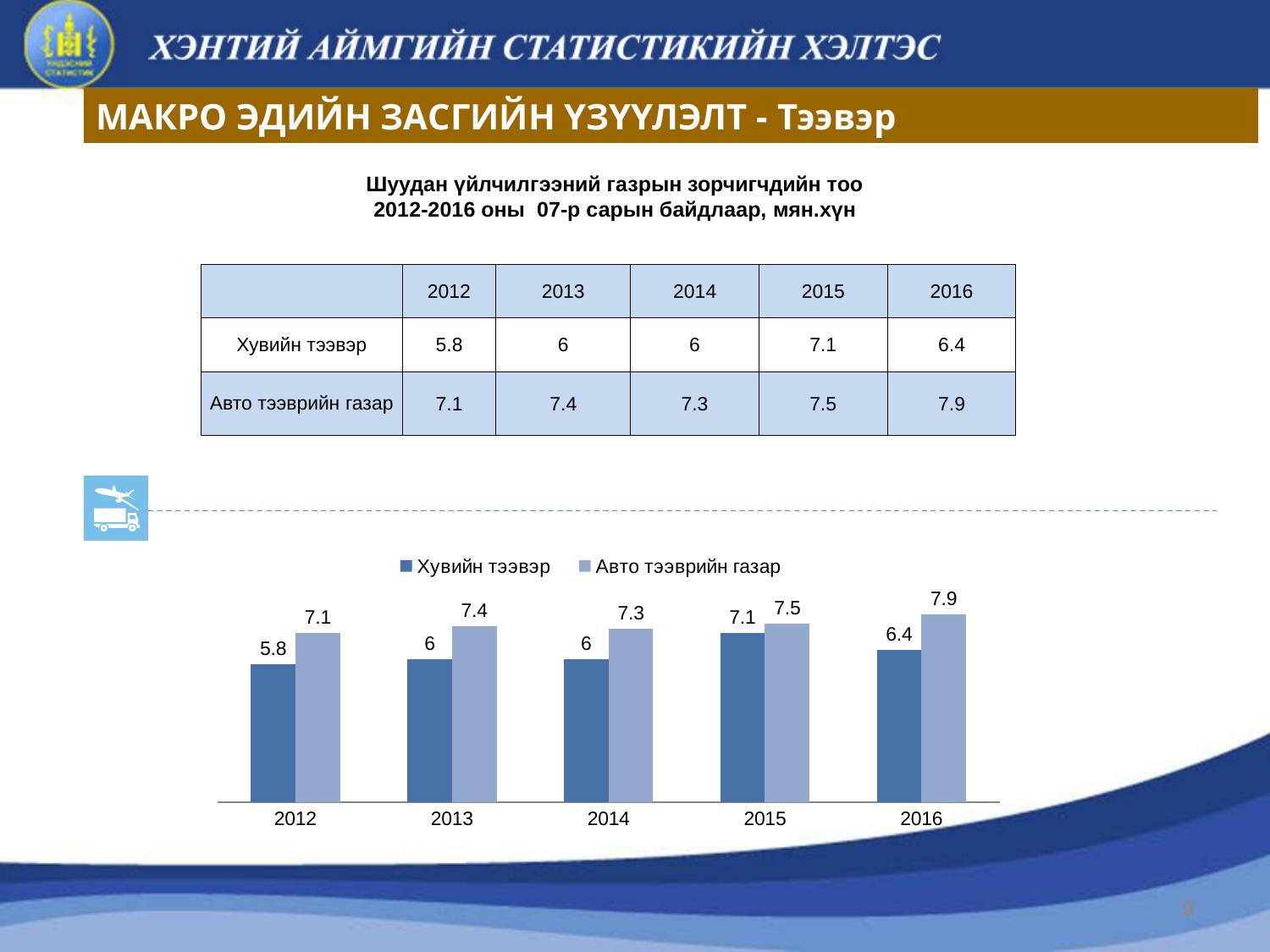
How many series does the chart legend list? 2 How many years are shown on the x axis of the chart? 5 In which year is the value for Хувийн тээвэр lowest? 2012 What is the value for Хувийн тээвэр in 2012? 5.8 In which year is the value for Авто тээврийн газар highest? 2016 What is the value for Хувийн тээвэр in 2015? 7.1 Does the value for Хувийн тээвэр rise or fall from 2015 to 2016? fall What is the value for Авто тээврийн газар in 2016? 7.9 What is the difference between Авто тээврийн газар and Хувийн тээвэр in 2016? 1.5 Which series has the larger value in 2013, Хувийн тээвэр or Авто тээврийн газар? Авто тээврийн газар What type of chart is shown on the slide? bar chart Which series is shown in the lighter blue colour in the chart? Авто тээврийн газар